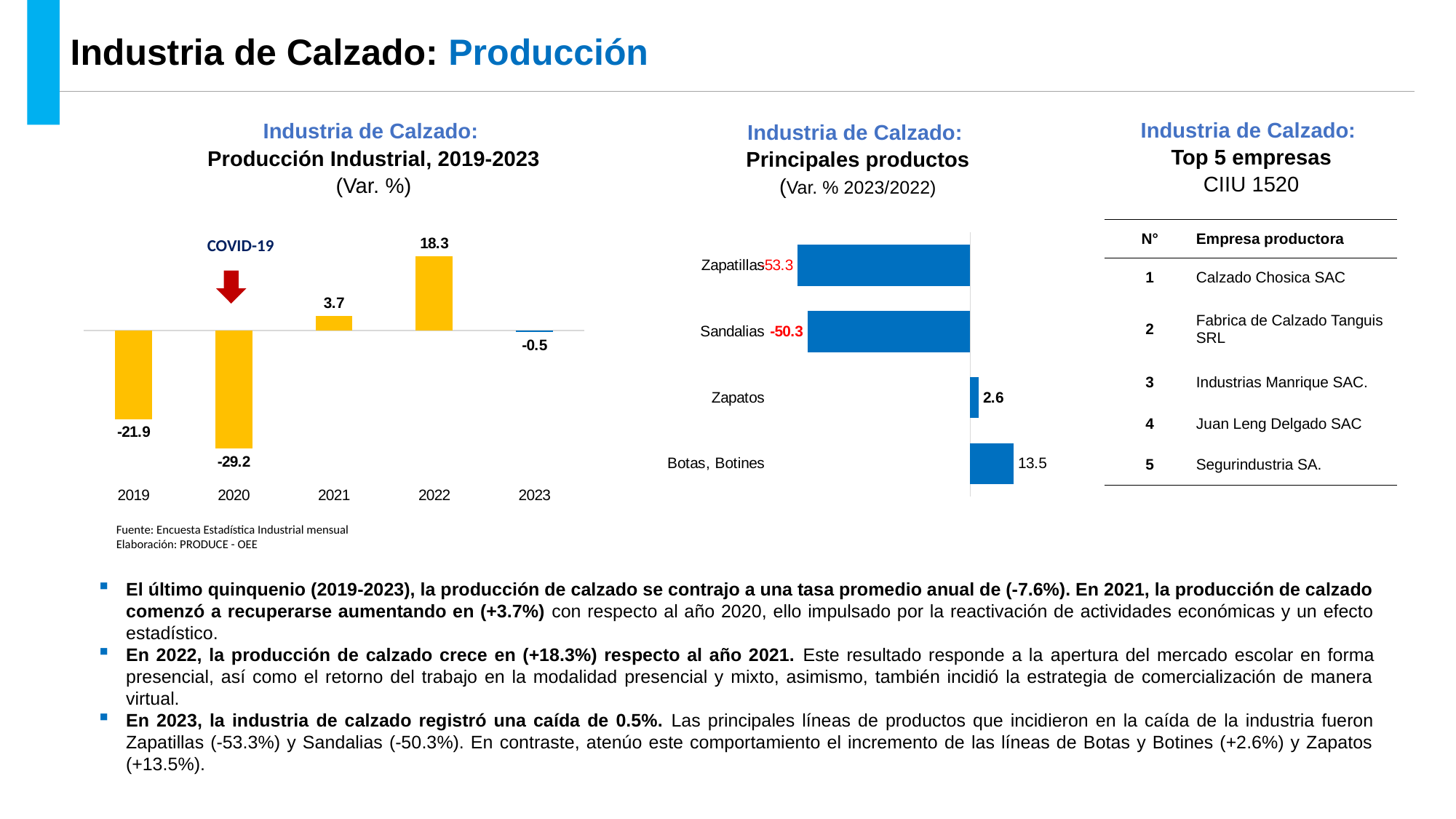
In the 'Principales productos' chart, which is larger, the value for Zapatos or the value for Botas, Botines? Botas, Botines In the 'Producción Industrial, 2019-2023' chart, what is the difference between the 2022 value and the 2021 value? 14.6 What type of chart is the 'Producción Industrial, 2019-2023' chart? Bar chart In the 'Principales productos' chart, what is the value for Sandalias? -50.3 In the 'Producción Industrial, 2019-2023' chart, which year has the highest value? 2022 In the 'Producción Industrial, 2019-2023' chart, what is the value for 2022? 18.3 In the 'Producción Industrial, 2019-2023' chart, how many years are plotted? 5 In the 'Principales productos' chart, what is the value for Botas, Botines? 13.5 In the 'Producción Industrial, 2019-2023' chart, what is the value for 2020? -29.2 In the 'Producción Industrial, 2019-2023' chart, what is the value for 2023? -0.5 In the 'Producción Industrial, 2019-2023' chart, which year has the lowest value? 2020 In the 'Principales productos' chart, how many product categories are shown? 4